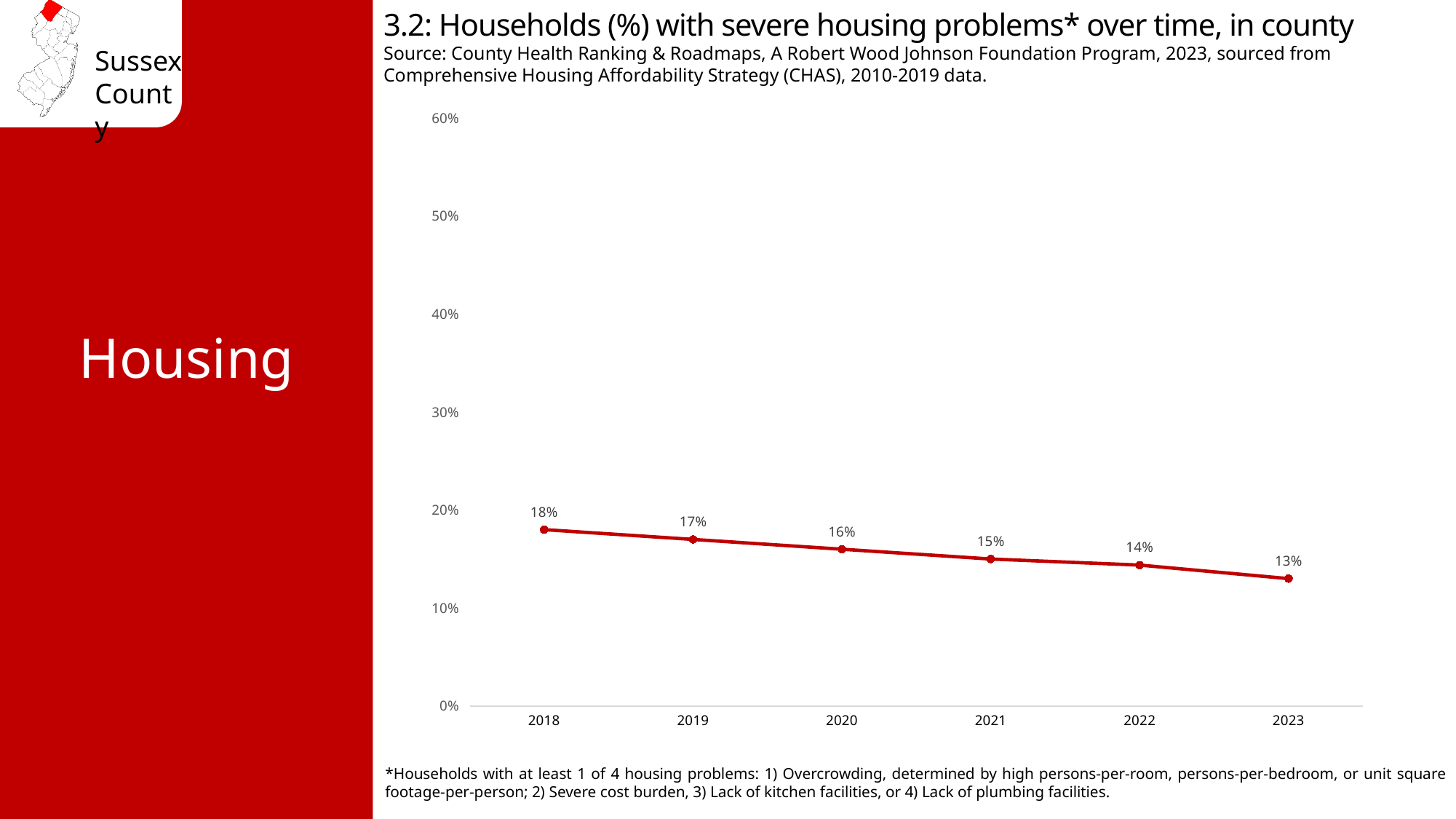
How many years are plotted on the chart? 6 Do the values rise or fall from 2018 to 2023? fall What is the value shown for 2021? 15% What is the title of the chart? 3.2: Households (%) with severe housing problems* over time, in county Is the value for 2020 greater or less than 20%? less What percentage of households had severe housing problems in 2023? 13% What is the difference between the 2018 value and the 2023 value? 5% Which year has the highest percentage of households with severe housing problems? 2018 What percentage of households had severe housing problems in 2018? 18% Which year has a higher value, 2019 or 2022? 2019 What kind of chart is shown on the slide? line chart Which year has the lowest percentage of households with severe housing problems? 2023